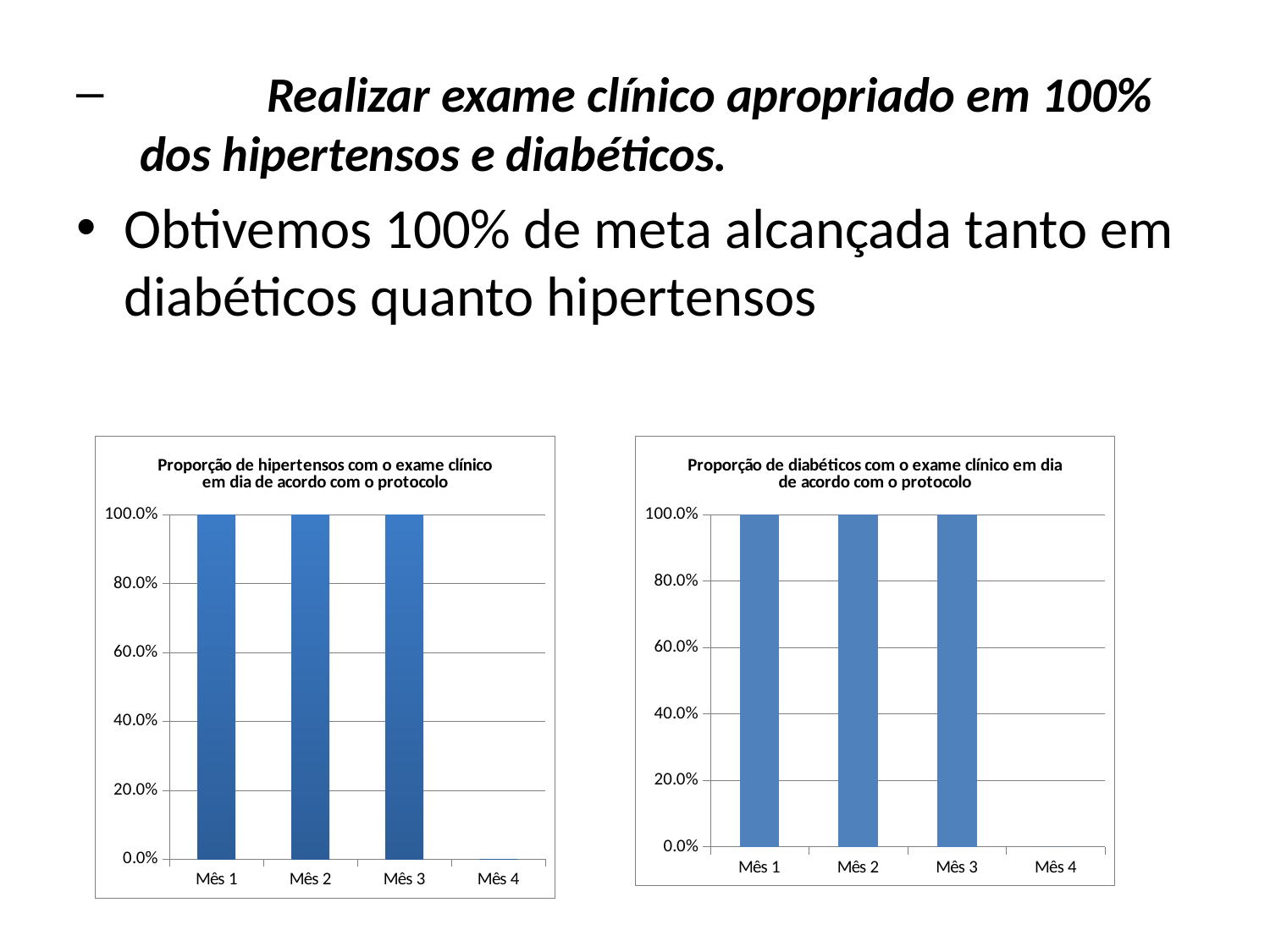
What kind of chart is the right chart, 'Proporção de diabéticos com o exame clínico em dia de acordo com o protocolo'? bar chart In the right chart (diabéticos), what is the value for Mês 3? 100.0% What is the title of the left chart? Proporção de hipertensos com o exame clínico em dia de acordo com o protocolo How many categories are shown on the x axis of the left chart (hipertensos)? 4 In the left chart (hipertensos), what is the value for Mês 1? 100.0% What is the title of the right chart? Proporção de diabéticos com o exame clínico em dia de acordo com o protocolo In the left chart (hipertensos), what is the value for Mês 3? 100.0% In the right chart (diabéticos), is the value for Mês 1 greater or less than 60.0%? greater In the right chart (diabéticos), what is the value for Mês 2? 100.0% What kind of chart is the left chart, 'Proporção de hipertensos com o exame clínico em dia de acordo com o protocolo'? bar chart In the left chart (hipertensos), is the value for Mês 2 greater or less than 80.0%? greater How many categories are shown on the x axis of the right chart (diabéticos)? 4